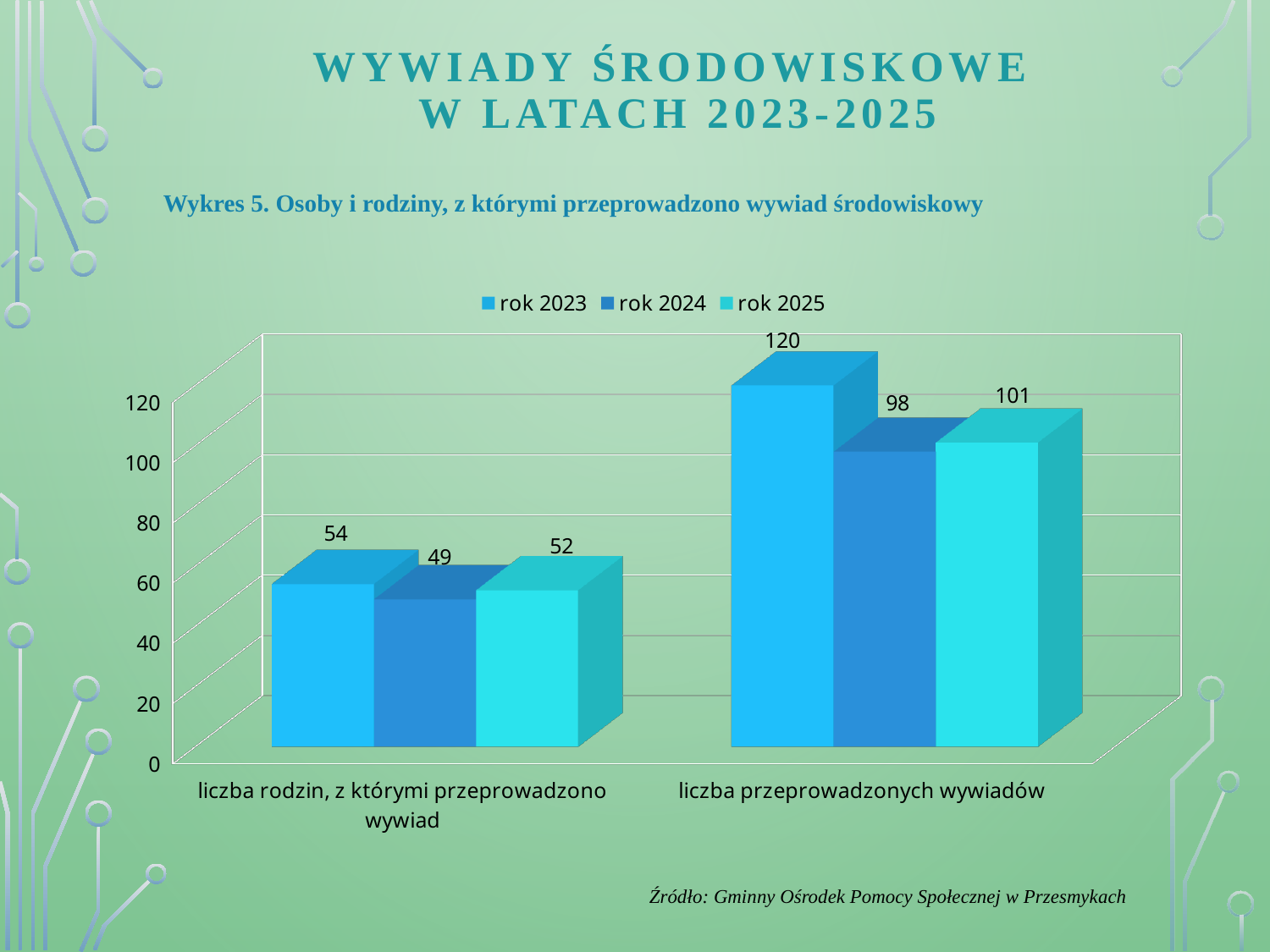
What is the value for 'rok 2023' in the category 'liczba rodzin, z którymi przeprowadzono wywiad'? 54 What is the difference between the 'rok 2023' and 'rok 2024' values for 'liczba przeprowadzonych wywiadów'? 22 What is the difference between the 'rok 2023' and 'rok 2025' values for 'liczba rodzin, z którymi przeprowadzono wywiad'? 2 What is the value for 'rok 2025' in the category 'liczba przeprowadzonych wywiadów'? 101 Which year has the highest value for 'liczba przeprowadzonych wywiadów'? rok 2023 What is the title of the chart (Wykres 5)? Osoby i rodziny, z którymi przeprowadzono wywiad środowiskowy How many categories are shown on the x axis? 2 Which year has the lowest value for 'liczba rodzin, z którymi przeprowadzono wywiad'? rok 2024 What is the value for 'rok 2024' in the category 'liczba przeprowadzonych wywiadów'? 98 What kind of chart is shown on the slide? bar chart Which is larger: the 'rok 2025' value for 'liczba przeprowadzonych wywiadów' or the 'rok 2024' value for the same category? rok 2025 How many series does the legend list? 3